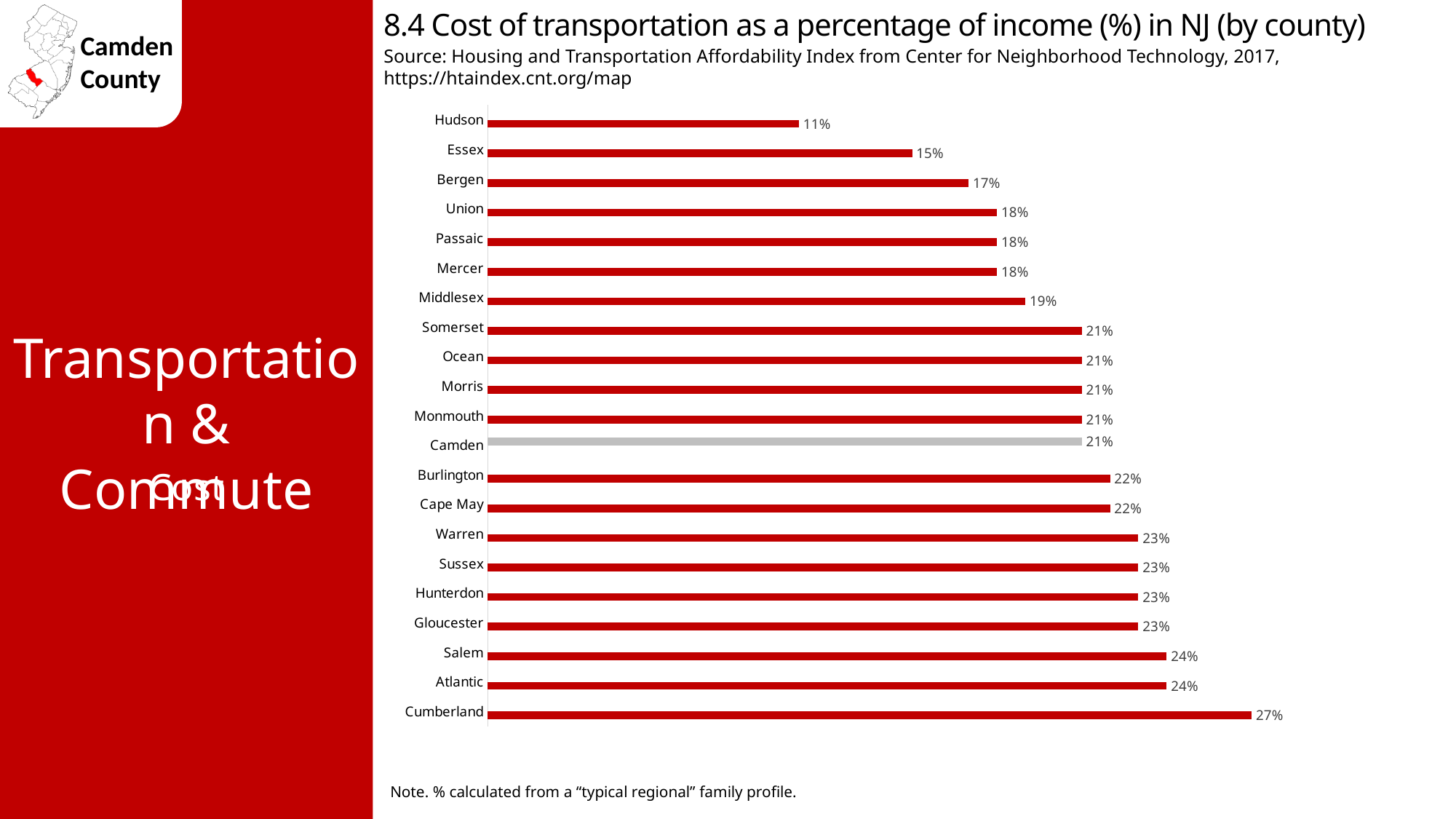
Which county has the lowest cost of transportation as a percentage of income? Hudson Which county has a higher cost of transportation as a percentage of income, Essex or Salem? Salem What is the cost of transportation as a percentage of income for Camden County? 21% What type of chart is shown on the slide? Bar chart Which county has the highest cost of transportation as a percentage of income? Cumberland What is the cost of transportation as a percentage of income for Middlesex County? 19% Which county's bar is shown in gray rather than red? Camden How many counties are shown in the chart? 21 What is the cost of transportation as a percentage of income for Cumberland County? 27% What is the cost of transportation as a percentage of income for Hudson County? 11% What is the difference in percentage points between Gloucester and Camden? 2 What is the difference in percentage points between Cumberland and Hudson? 16